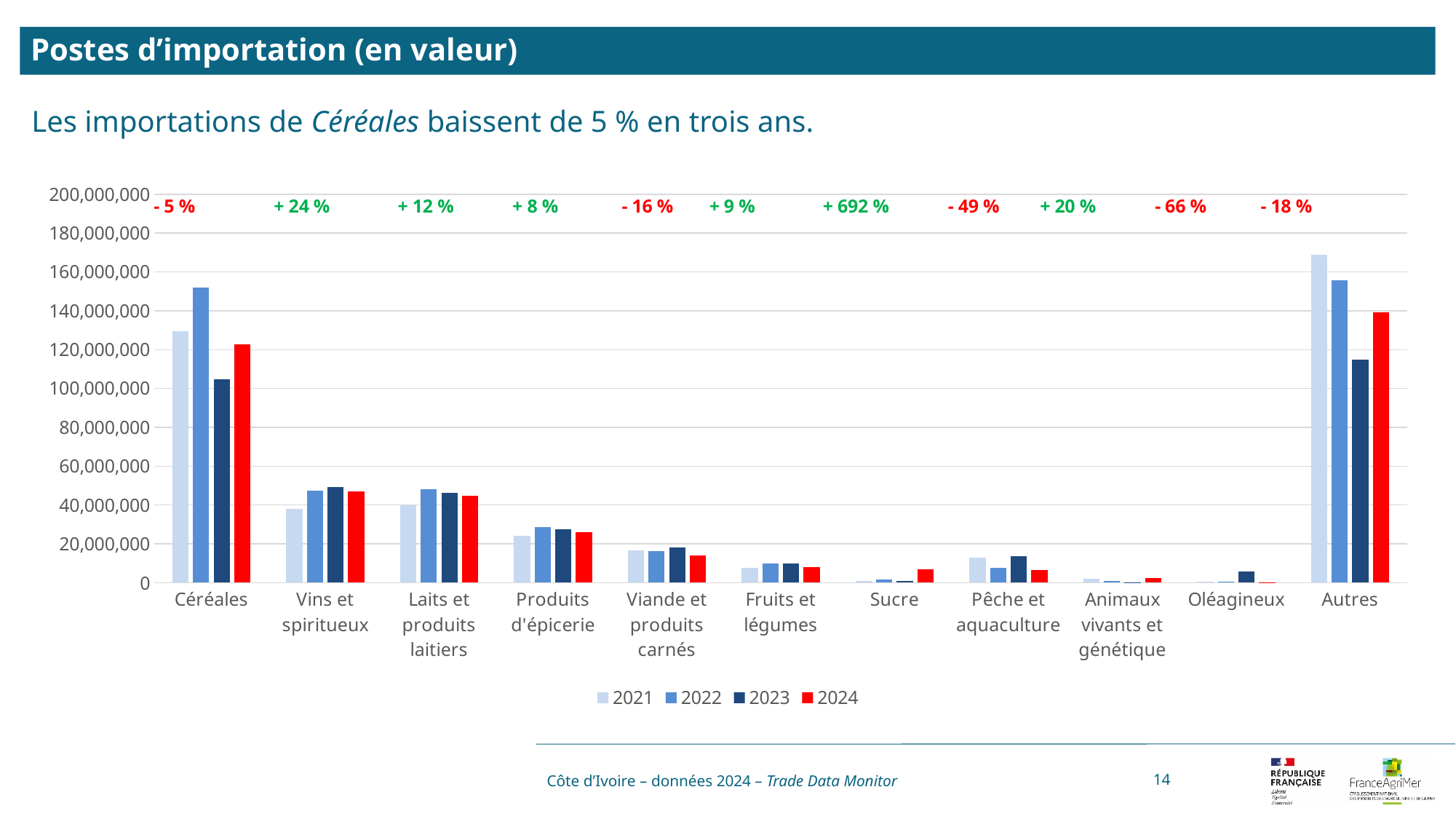
Which category has the highest percentage change printed above it? Sucre What percentage change is printed above the Sucre category? + 692 % What kind of chart is shown on the slide? bar chart What percentage change is printed above the Oléagineux category? - 66 % Is the 2022 value for Céréales greater or less than 140,000,000? greater How many import categories are shown on the x axis? 11 Is the 2023 value for Autres greater or less than 100,000,000? greater What percentage change is printed above the Céréales category? - 5 % For Céréales, which is larger: the 2021 value or the 2023 value? 2021 Which category has the tallest 2021 bar? Autres How many series does the legend list? 4 Which category has the lowest percentage change printed above it? Oléagineux